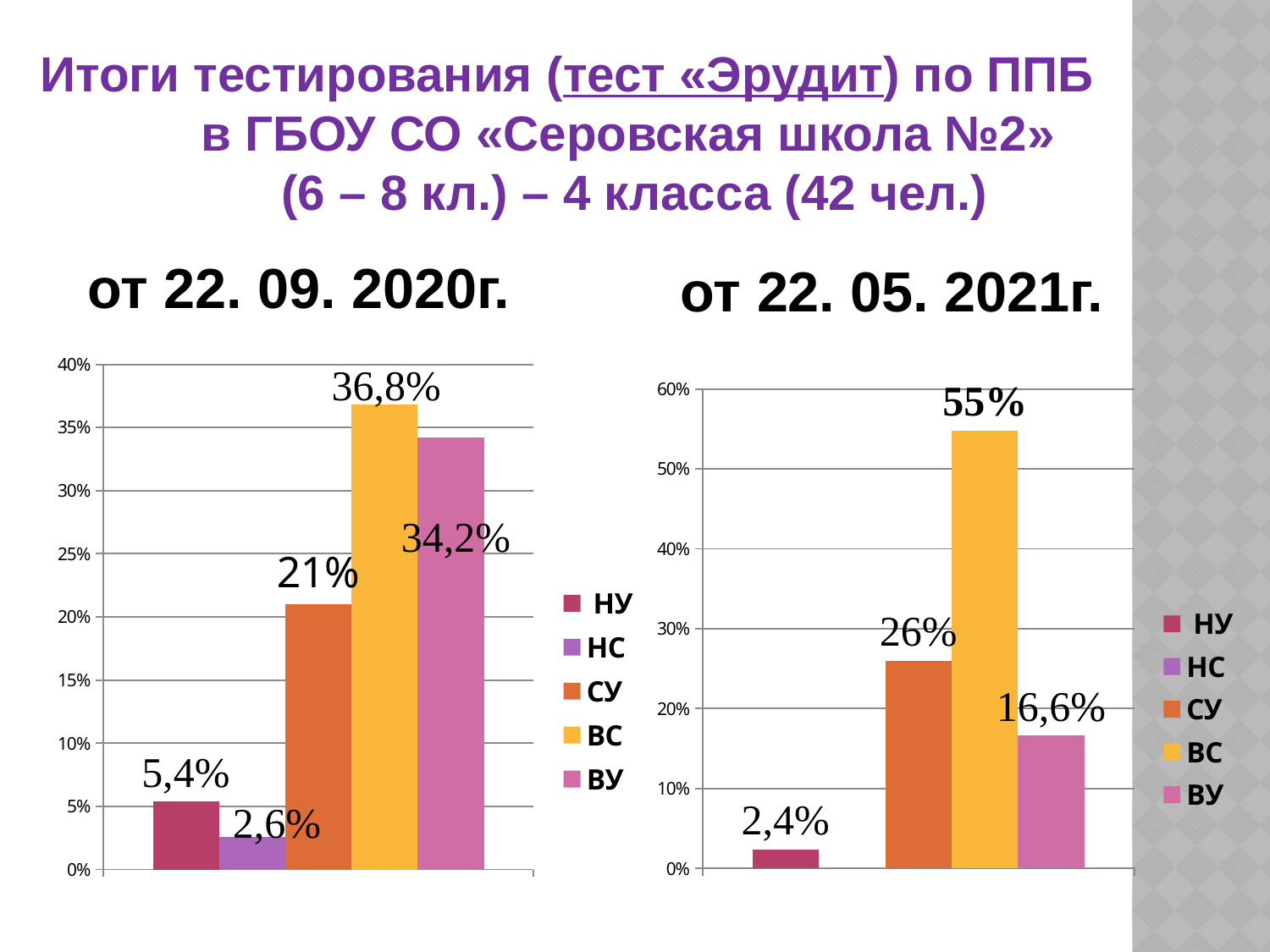
In the chart titled "от 22. 09. 2020г.", which series has the lowest value? НС In the chart titled "от 22. 05. 2021г.", what is the value for СУ? 26% How many series does the legend of the chart titled "от 22. 09. 2020г." list? 5 In the chart titled "от 22. 05. 2021г.", what is the difference between the values for ВС and СУ? 29% In the chart titled "от 22. 09. 2020г.", what is the value for НС? 2,6% In the chart titled "от 22. 05. 2021г.", which series has the highest value? ВС What kind of chart is the chart titled "от 22. 05. 2021г."? bar chart In the chart titled "от 22. 05. 2021г.", is the value for ВС greater or less than 50%? greater In the chart titled "от 22. 09. 2020г.", which is larger, the value for СУ or the value for НУ? СУ In the chart titled "от 22. 05. 2021г.", what is the value for ВУ? 16,6% In the chart titled "от 22. 09. 2020г.", what is the value for ВС? 36,8% In the chart titled "от 22. 09. 2020г.", what is the difference between the values for ВС and ВУ? 2,6%